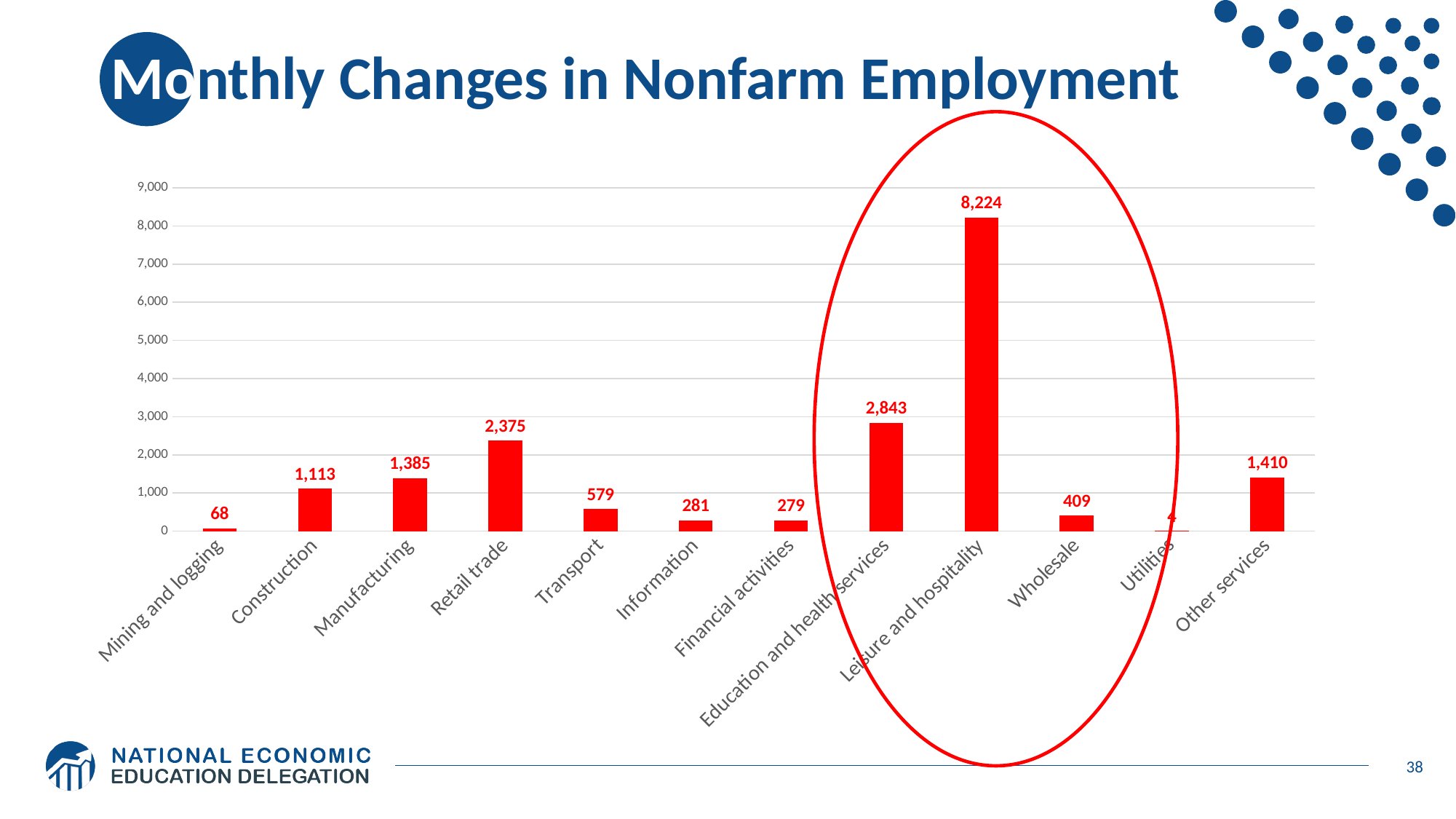
What is the value for Retail trade? 2,375 Which is larger, the value for Manufacturing or the value for Construction? Manufacturing What kind of chart is shown on the slide? Bar chart What is the title of the slide? Monthly Changes in Nonfarm Employment How many categories are shown on the x axis? 12 Which category has the lowest value? Utilities What is the difference between the values for Leisure and hospitality and Education and health services? 5,381 Which category has the highest value? Leisure and hospitality What is the value for Other services? 1,410 What is the value for Mining and logging? 68 What is the value for Leisure and hospitality? 8,224 Is the value for Education and health services greater or less than 2,000? greater